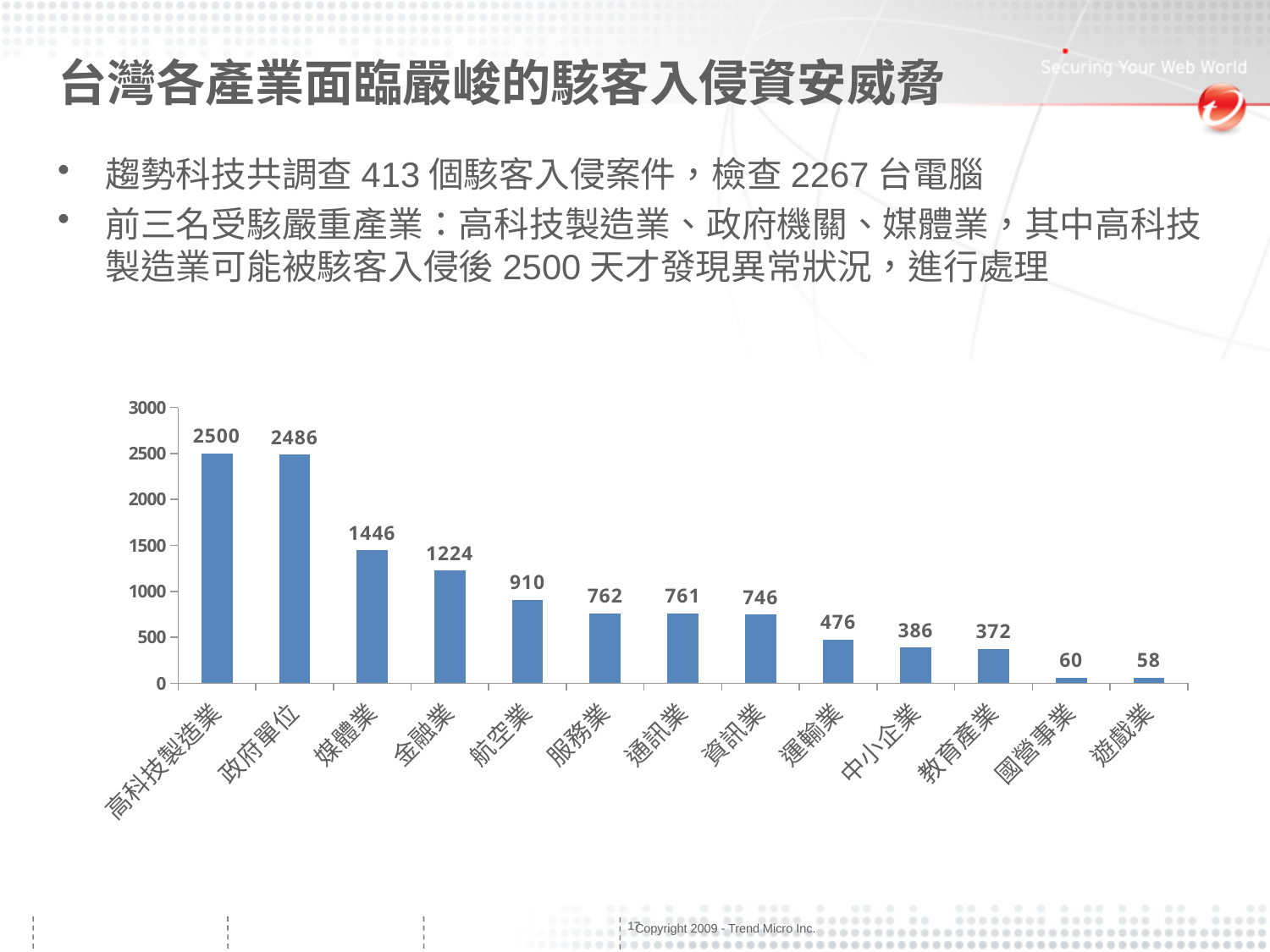
What is the value for 中小企業? 386 How many categories are shown on the x axis? 13 What is the value for 航空業? 910 Is the value for 金融業 greater or less than 1000? greater What is the difference between the values for 高科技製造業 and 政府單位? 14 What kind of chart is shown on the slide? bar chart What is the difference between the values for 媒體業 and 金融業? 222 What is the value for 媒體業? 1446 Which category has the highest value? 高科技製造業 Which is larger, the value for 運輸業 or the value for 教育產業? 運輸業 Which category has the lowest value? 遊戲業 Do the values rise or fall from left to right along the x axis? fall